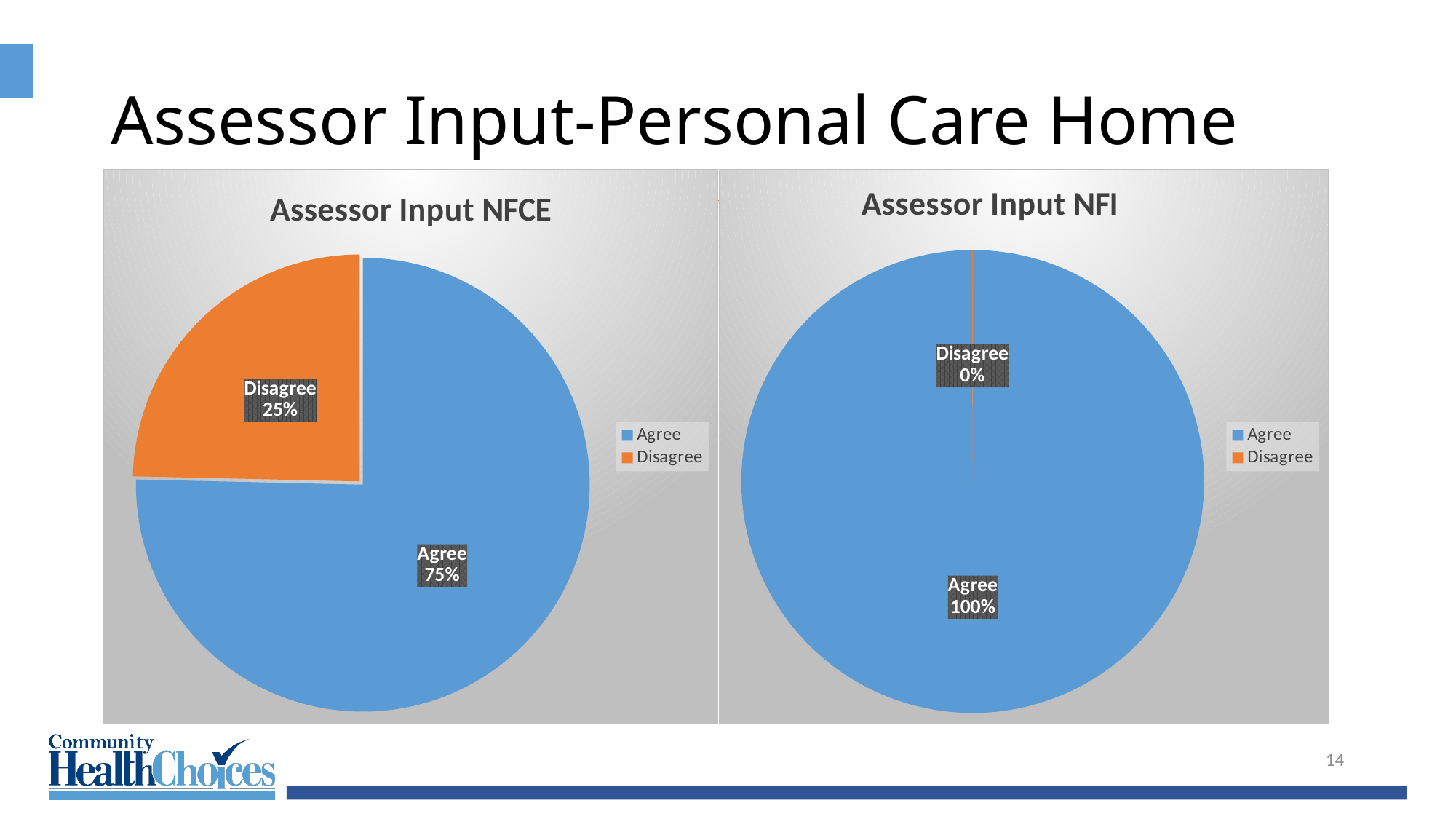
In the Assessor Input NFCE chart, which slice is the smallest? Disagree In the Assessor Input NFI chart, what percentage is labelled for Agree? 100% In the Assessor Input NFCE chart, what percentage is labelled for Disagree? 25% In the Assessor Input NFI chart, what percentage is labelled for Disagree? 0% In the Assessor Input NFCE chart, which is larger, Agree or Disagree? Agree In the Assessor Input NFCE chart, what colour is the Disagree slice? Orange In the Assessor Input NFCE chart, what is the difference in percentage points between Agree and Disagree? 50 How many charts are shown on the slide? 2 How many entries does the legend of the Assessor Input NFCE chart list? 2 What type of chart is the Assessor Input NFI chart? Pie chart In the Assessor Input NFCE chart, which slice is the largest? Agree In the Assessor Input NFCE chart, what percentage is labelled for Agree? 75%